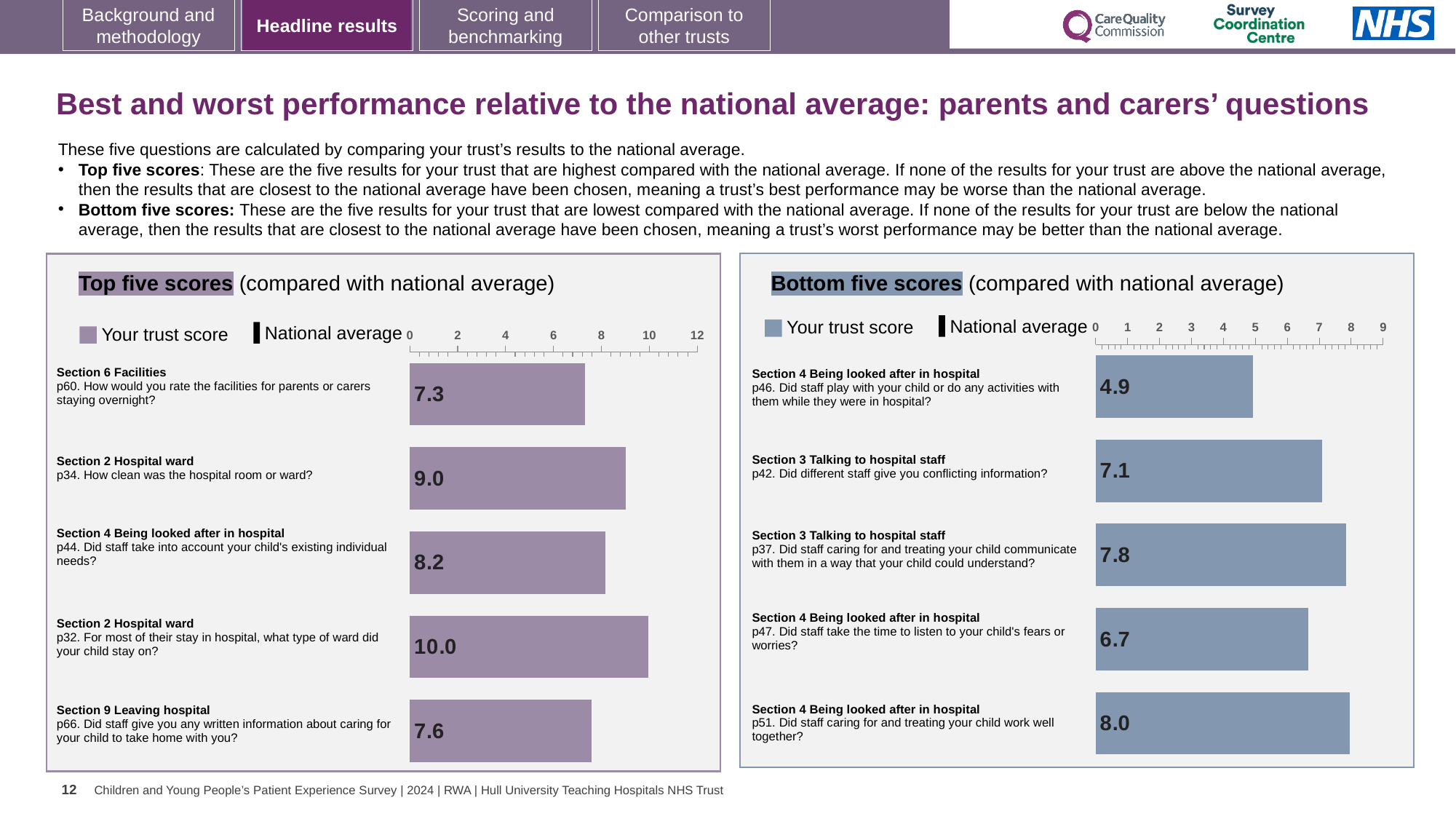
In the Bottom five scores chart, what is the trust score for p46 'Did staff play with your child or do any activities with them while they were in hospital?' 4.9 What type of chart is the Top five scores chart? Bar chart In the Top five scores chart, what is the trust score for p34 'How clean was the hospital room or ward?' 9.0 In the Bottom five scores chart, what is the difference between the trust scores for p51 and p47? 1.3 How many questions are shown in the Bottom five scores chart? 5 In the Top five scores chart, which question has the highest trust score? p32. For most of their stay in hospital, what type of ward did your child stay on? In the Top five scores chart, is the trust score for p66 greater or less than 8? less In the Bottom five scores chart, which has the larger trust score: p42 or p37? p37 What is the maximum value shown on the axis of the Bottom five scores chart? 9 How many series does the legend of the Top five scores chart list? 2 In the Top five scores chart, what is the difference between the trust scores for p32 and p60? 2.7 In the Bottom five scores chart, which question has the lowest trust score? p46. Did staff play with your child or do any activities with them while they were in hospital?